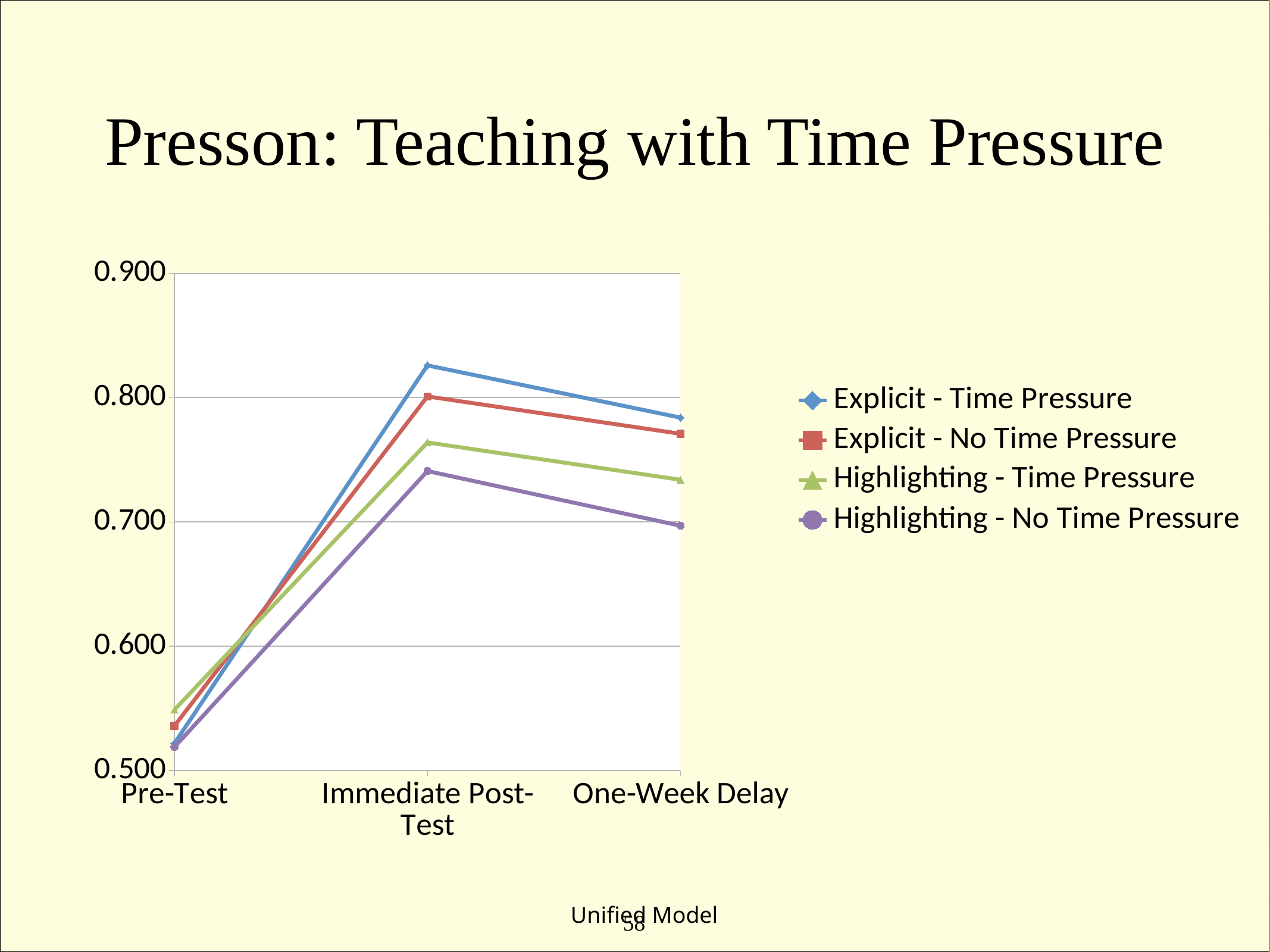
What kind of chart is shown on the slide? Line chart Which series has the lowest value at One-Week Delay? Highlighting - No Time Pressure Which series has the highest value at Pre-Test? Highlighting - Time Pressure Does the Explicit - Time Pressure line rise or fall from Immediate Post-Test to One-Week Delay? Fall Is the value for Explicit - No Time Pressure at One-Week Delay greater or less than 0.800? less Which series has the highest value at Immediate Post-Test? Explicit - Time Pressure Is the value for Highlighting - Time Pressure at Immediate Post-Test greater or less than 0.800? less Which series has the lowest value at Immediate Post-Test? Highlighting - No Time Pressure At Immediate Post-Test, which is larger: Explicit - Time Pressure or Highlighting - No Time Pressure? Explicit - Time Pressure How many series does the legend list? 4 How many categories are shown on the x axis? 3 Is the value for Explicit - Time Pressure at Immediate Post-Test greater or less than 0.800? greater